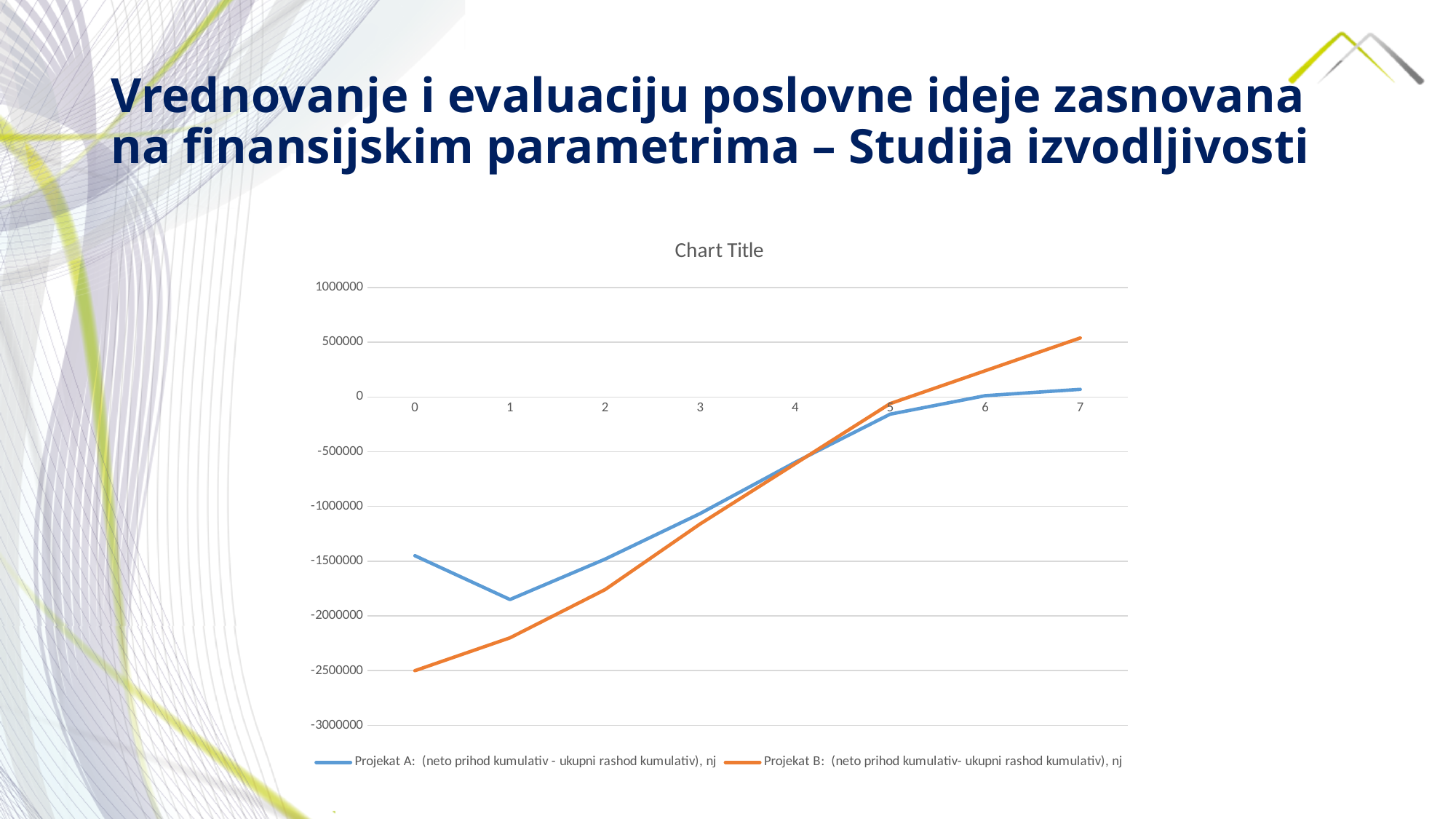
How many series does the legend list? 2 Which colour is used for the Projekat B line? orange What is the title shown above the chart? Chart Title At x = 0, which series has the higher value, Projekat A or Projekat B? Projekat A At x = 7, which series has the higher value, Projekat A or Projekat B? Projekat B Is the value for Projekat A at x = 1 greater or less than -1500000? less What kind of chart is shown on the slide? line chart Is the value for Projekat B at x = 7 greater or less than 500000? greater How many points are plotted along the x axis for each series? 8 Is the value for Projekat B at x = 1 greater or less than -2000000? less Does the Projekat B line rise or fall from x = 0 to x = 7? rise